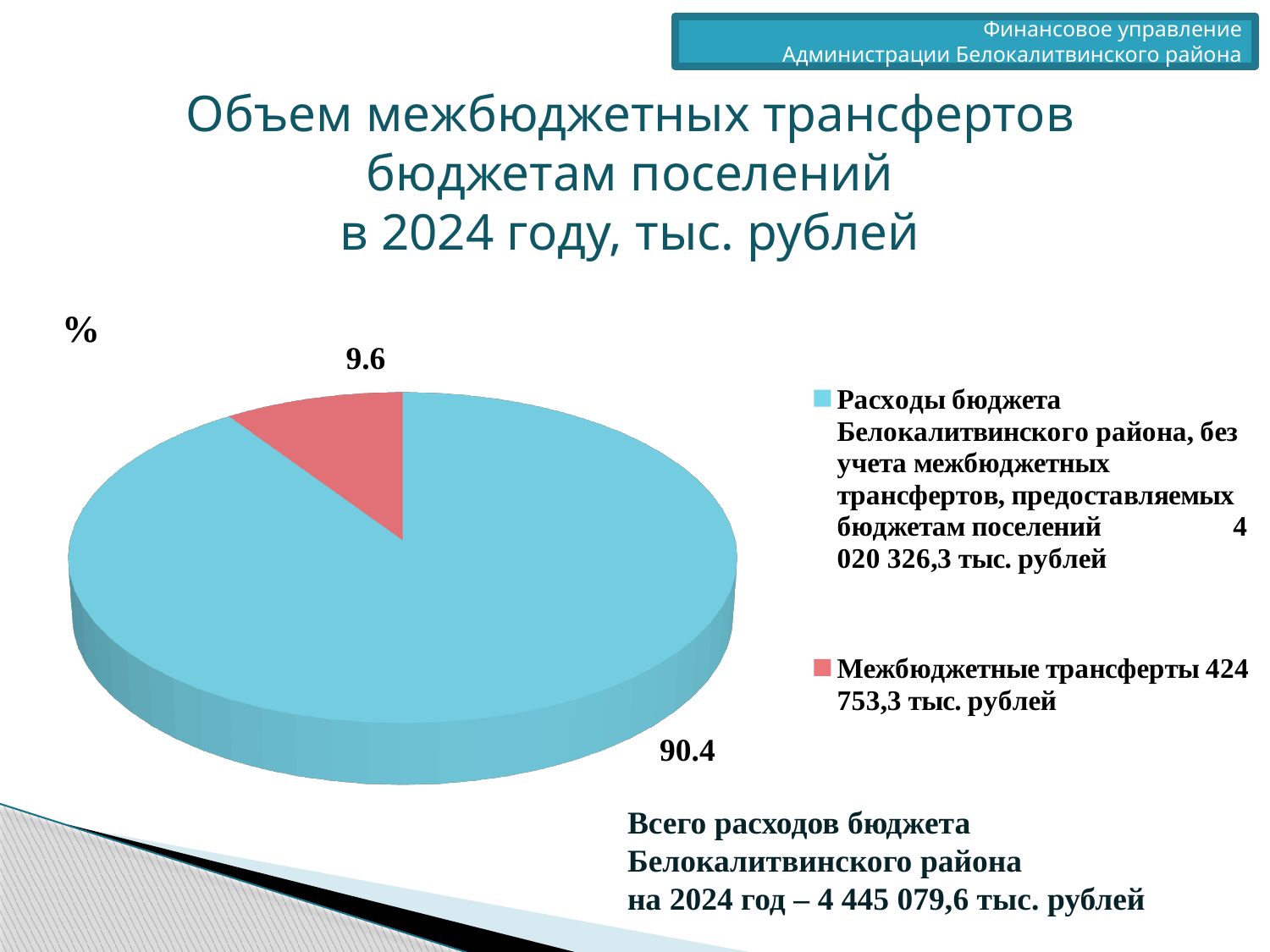
What amount in thousand rubles is given in the legend for "Межбюджетные трансферты"? 424 753,3 тыс. рублей How many slices does the pie chart have? 2 What percentage is shown for the slice "Межбюджетные трансферты"? 9.6 What colour is the slice representing "Межбюджетные трансферты"? Red What is the difference in percentage points between the two slices of the pie chart? 80.8 Which slice of the pie chart is the smallest? Межбюджетные трансферты How many entries does the legend of the pie chart list? 2 Which slice of the pie chart is the largest? Расходы бюджета Белокалитвинского района, без учета межбюджетных трансфертов, предоставляемых бюджетам поселений What percentage is shown for the slice "Расходы бюджета Белокалитвинского района, без учета межбюджетных трансфертов, предоставляемых бюджетам поселений"? 90.4 What kind of chart is shown on the slide? Pie chart Which is larger: the share for "Межбюджетные трансферты" or the share for "Расходы бюджета Белокалитвинского района, без учета межбюджетных трансфертов"? Расходы бюджета Белокалитвинского района, без учета межбюджетных трансфертов What unit symbol is shown at the top left of the pie chart? %